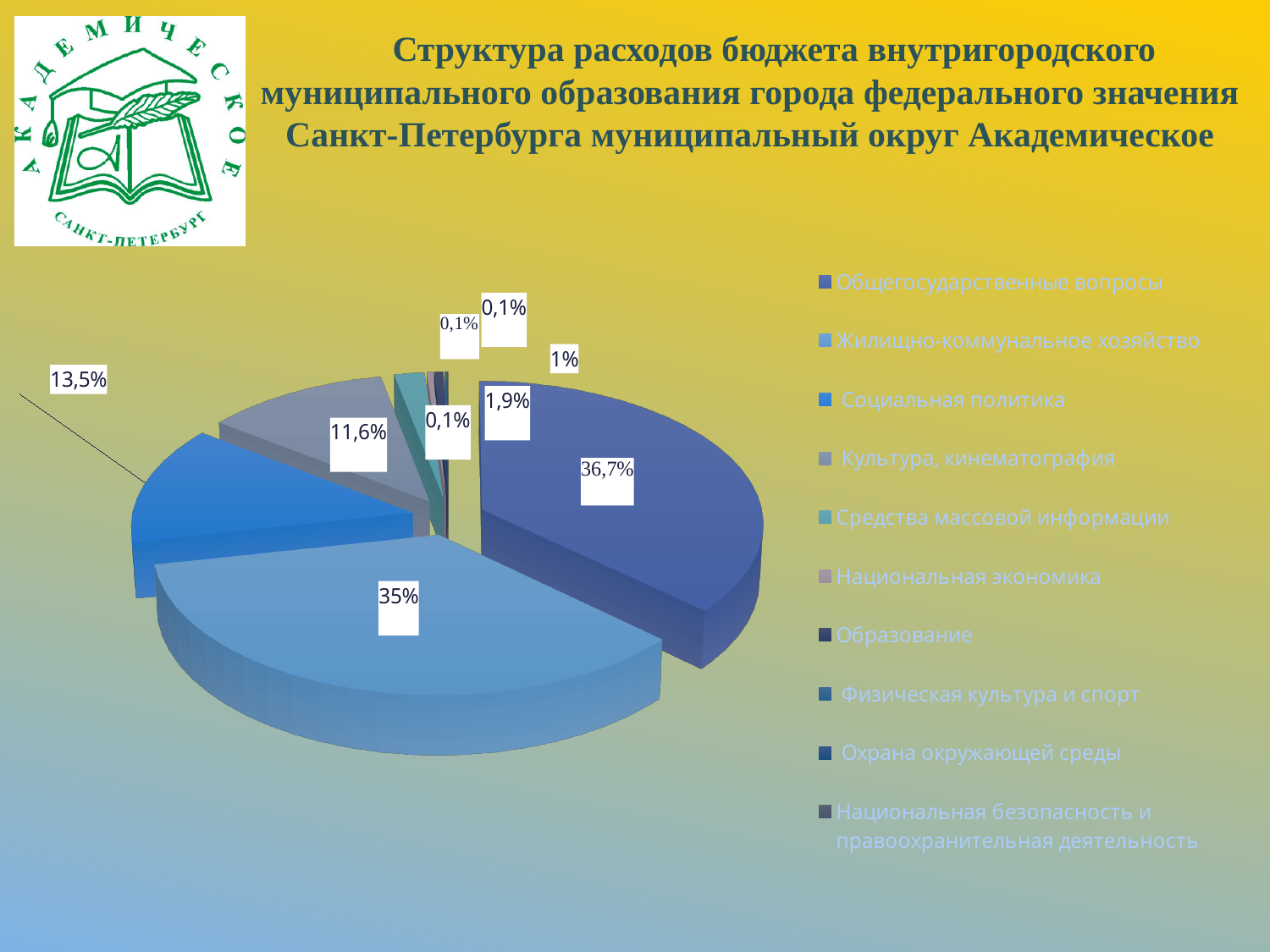
What share of the budget expenditure is labelled for Общегосударственные вопросы? 36,7% What share is shown for Социальная политика? 13,5% By how many percentage points does the 36,7% slice exceed the 35% slice? 1,7% How many slices on the pie chart are labelled 0,1%? 3 What is the largest share shown on the pie chart? 36,7% What share is shown for Культура, кинематография? 11,6% Which municipal district (муниципальный округ) is named in the chart title? Академическое Which has the larger share: Социальная политика or Культура, кинематография? Социальная политика What kind of chart is shown on the slide? pie chart What share is shown for Жилищно-коммунальное хозяйство? 35% How many categories does the legend of the pie chart list? 10 What is the combined share of the two largest slices (36,7% and 35%)? 71,7%